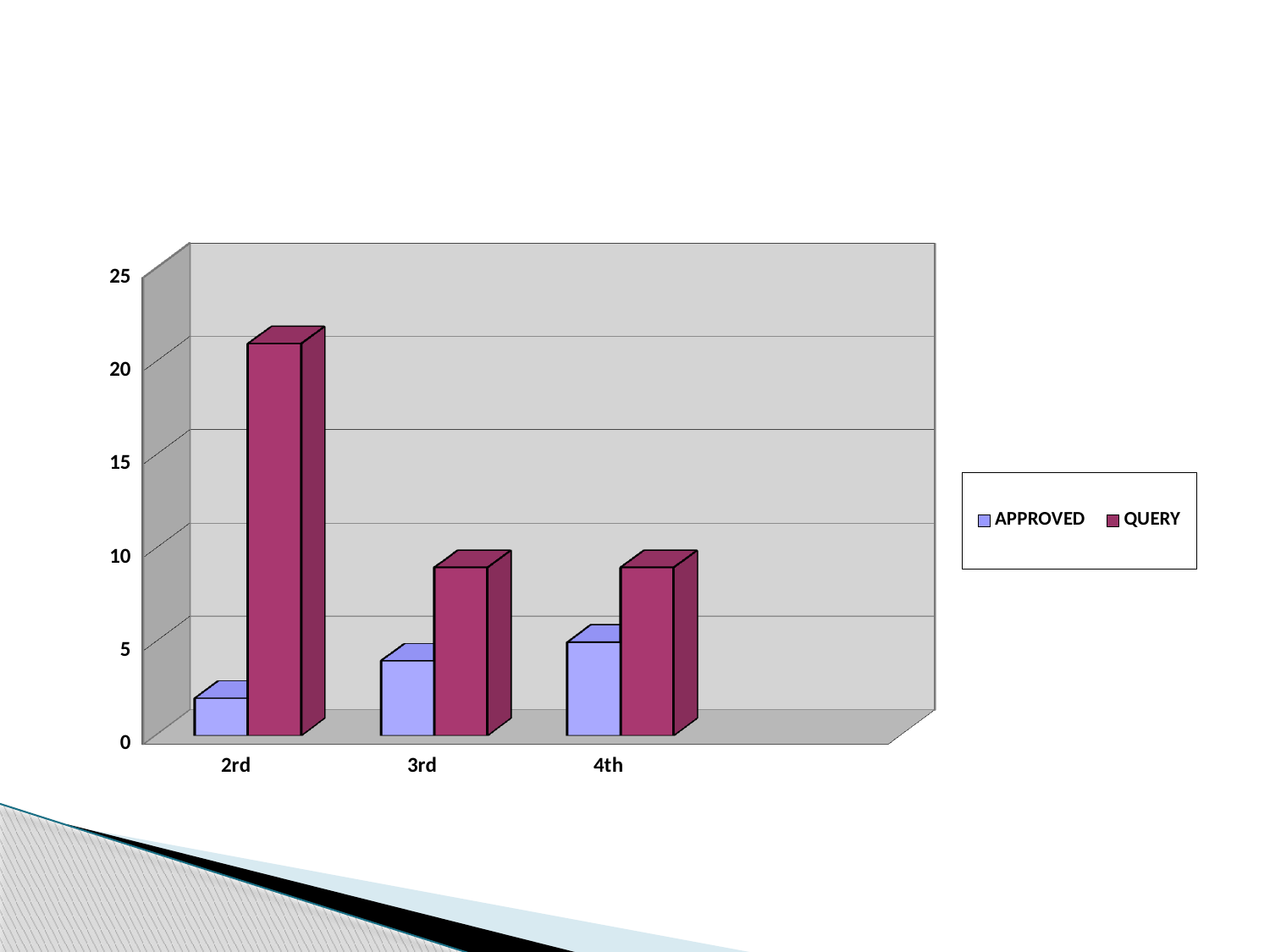
Which series does the legend list first? APPROVED How many series does the legend list? 2 Is the QUERY value for 3rd greater or less than 10? less How many categories are shown on the x axis? 3 Is the QUERY value for 2rd greater or less than 15? greater Which category has the highest QUERY value? 2rd Which is larger, the APPROVED value for 2rd or the APPROVED value for 4th? 4th Which is larger for 2rd, the APPROVED value or the QUERY value? QUERY Is the APPROVED value for 2rd greater or less than 5? less Which category has the lowest APPROVED value? 2rd Do the APPROVED values rise or fall from 2rd to 4th? rise What kind of chart is shown on the slide? bar chart